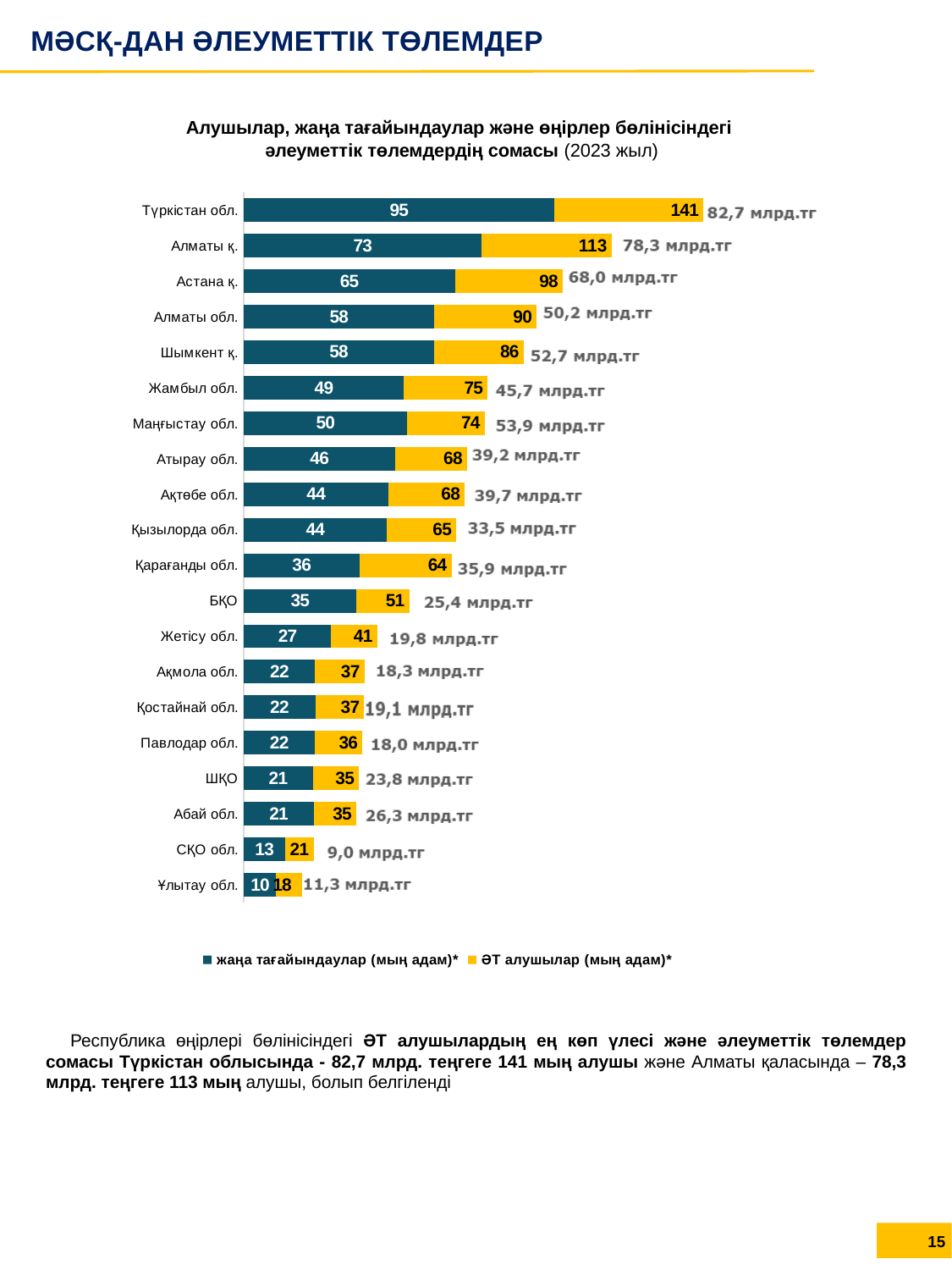
Which is larger: the "жаңа тағайындаулар (мың адам)*" value for Жамбыл обл. or for Маңғыстау обл.? Маңғыстау обл. What is the value of "ӘТ алушылар (мың адам)*" for Түркістан обл.? 141 What is the difference between the "ӘТ алушылар (мың адам)*" values for Түркістан обл. and Алматы қ.? 28 What amount in млрд.тг is shown next to the bar for Астана қ.? 68,0 млрд.тг Which region has the highest value of "ӘТ алушылар (мың адам)*"? Түркістан обл. How many regions (categories) are plotted in the chart? 20 What is the value of "жаңа тағайындаулар (мың адам)*" for Алматы қ.? 73 What kind of chart is shown on the slide? bar chart How many series does the legend list? 2 What is the value of "ӘТ алушылар (мың адам)*" for Қарағанды обл.? 64 Which region has the lowest value of "жаңа тағайындаулар (мың адам)*"? Ұлытау обл. Which series is shown in yellow in the chart? ӘТ алушылар (мың адам)*